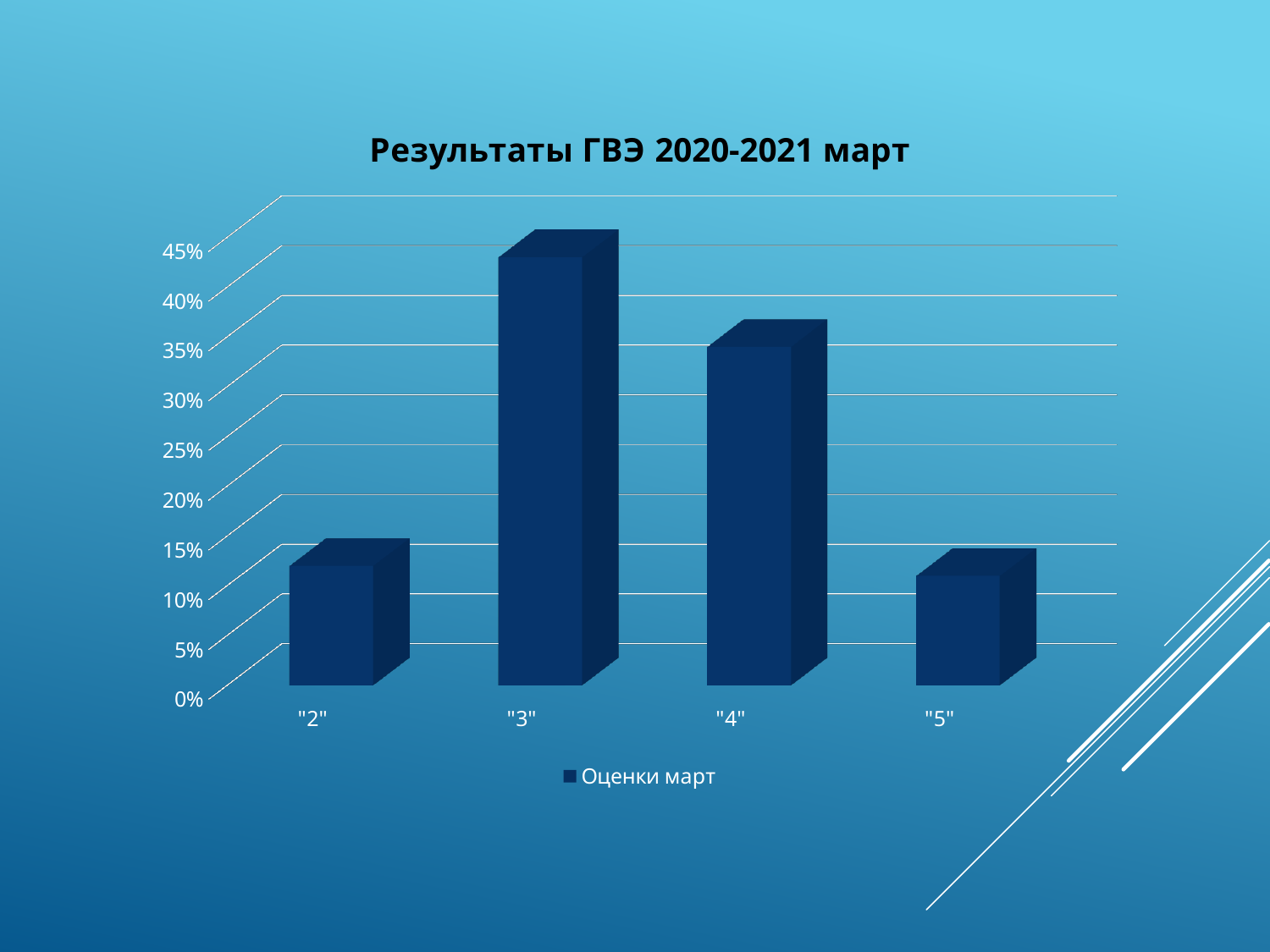
What kind of chart is shown on the slide? bar chart Which is larger, the value for "3" or the value for "4"? "3" Is the value for "2" greater or less than 20%? less Is the value for "3" greater or less than 40%? greater What is the title of the chart? Результаты ГВЭ 2020-2021 март Is the value for "4" greater or less than 30%? greater How many categories are shown on the x axis of the chart? 4 Which category has the highest value? "3" How many series does the legend list? 1 What is the name of the series shown in the legend? Оценки март Which is larger, the value for "2" or the value for "4"? "4"